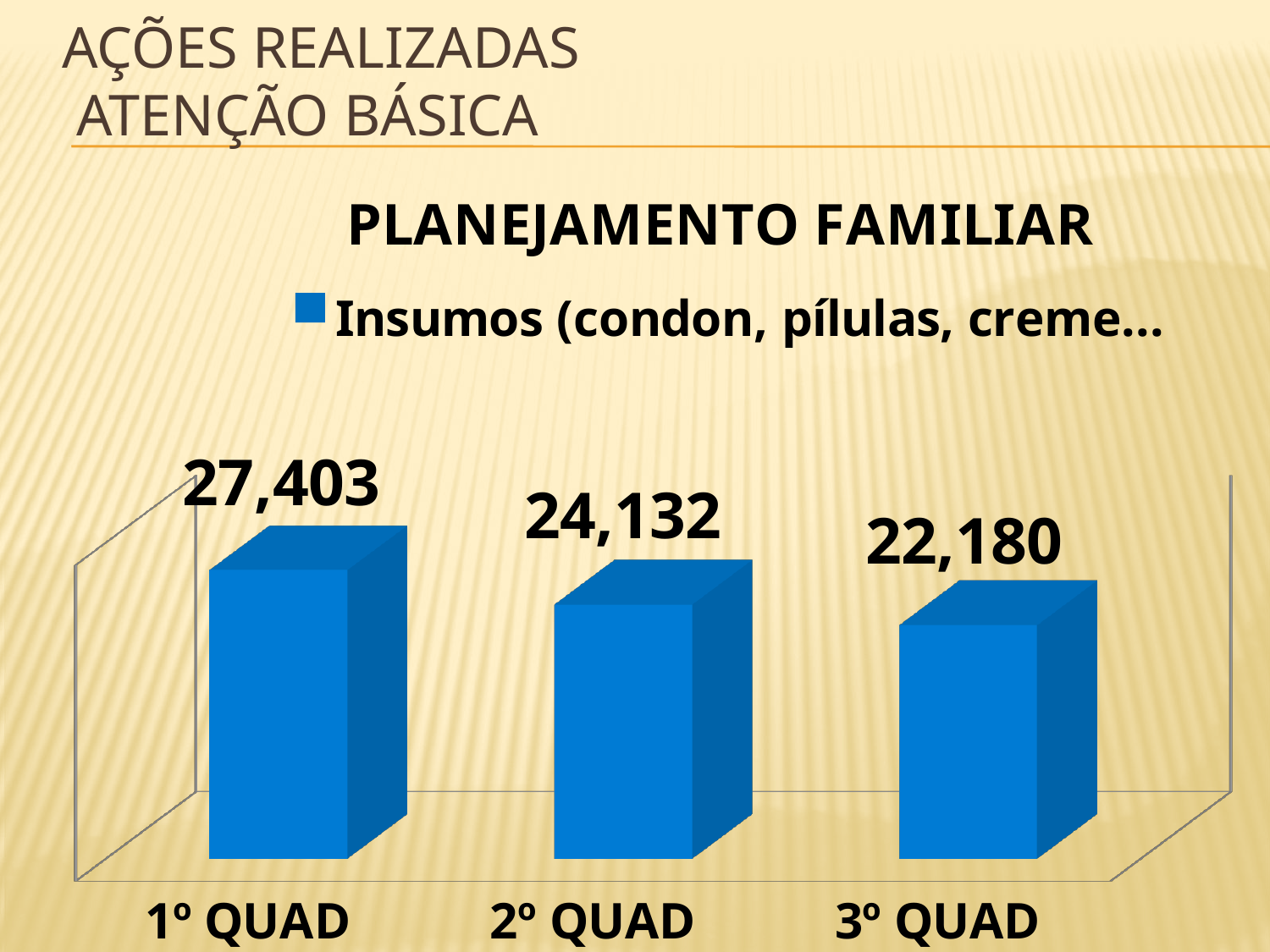
What is the difference between the values for 1º QUAD and 2º QUAD? 3,271 What is the value for 1º QUAD? 27,403 What is the difference between the values for 2º QUAD and 3º QUAD? 1,952 Which category has the highest value? 1º QUAD Which category has the lowest value? 3º QUAD Do the values rise or fall from 1º QUAD to 3º QUAD? fall What kind of chart is shown on the slide? bar chart What is the value for 2º QUAD? 24,132 Which is larger, the value for 1º QUAD or the value for 3º QUAD? 1º QUAD How many categories are shown on the x axis? 3 How many series does the legend list? 1 What is the value for 3º QUAD? 22,180